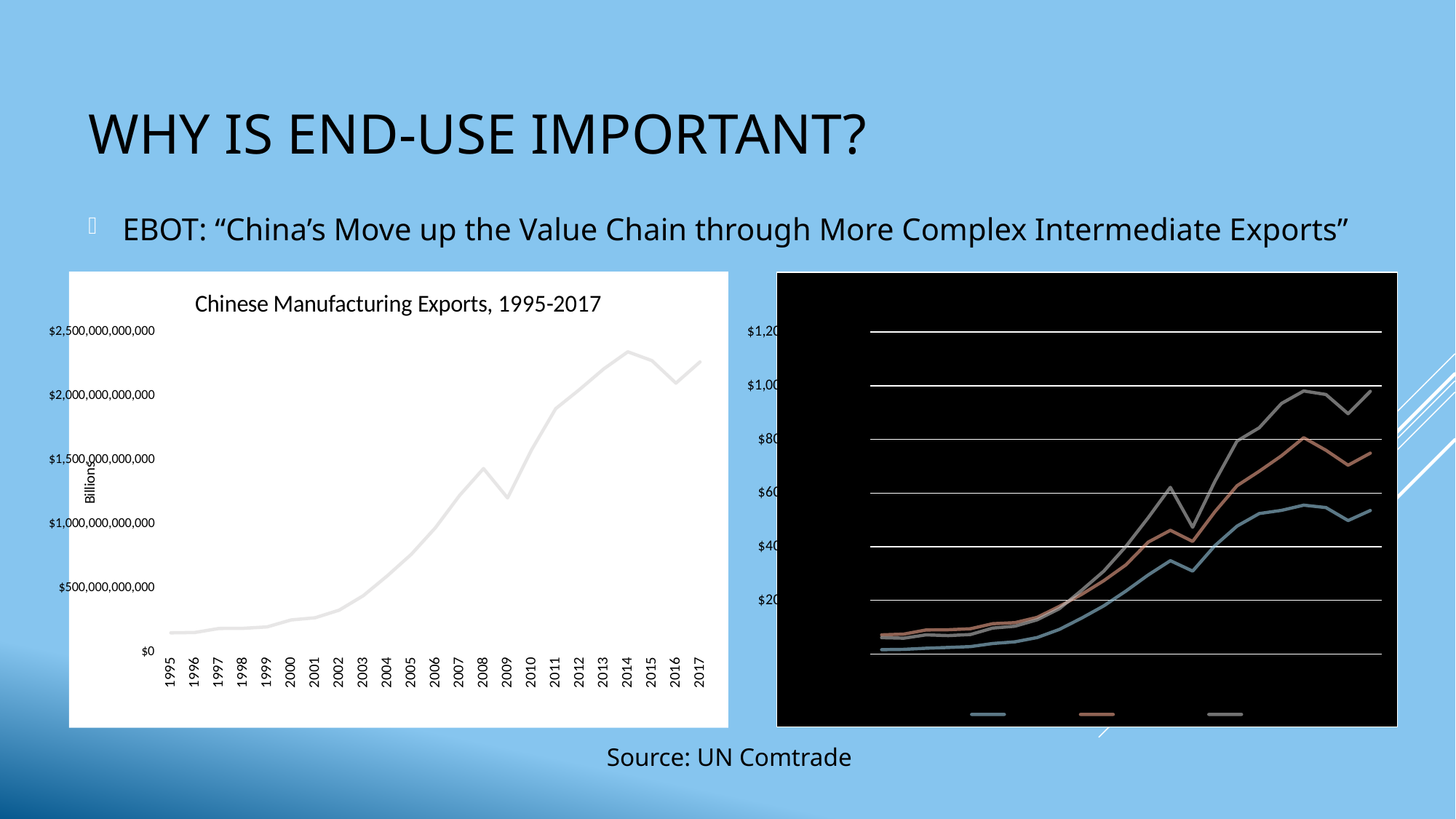
In the 'Chinese Manufacturing Exports, 1995-2017' chart, which year has the larger value, 2008 or 2009? 2008 In the 'Chinese Manufacturing Exports, 1995-2017' chart, is the value for 2009 greater or less than $1,500,000,000,000? less In the 'Chinese Manufacturing Exports, 1995-2017' chart, which year has the larger value, 2014 or 2016? 2014 How many years are plotted on the x axis of the 'Chinese Manufacturing Exports, 1995-2017' chart? 23 How many series does the legend of the chart with the black background on the right list? 3 In the 'Chinese Manufacturing Exports, 1995-2017' chart, which year has the lowest value? 1995 In the 'Chinese Manufacturing Exports, 1995-2017' chart, do the values generally rise or fall from 1995 to 2017? Rise In the 'Chinese Manufacturing Exports, 1995-2017' chart, is the value for 2003 greater or less than $500,000,000,000? less In the 'Chinese Manufacturing Exports, 1995-2017' chart, is the value for 2017 greater or less than $2,000,000,000,000? greater What kind of chart is the chart with the black background on the right of the slide? Line chart What kind of chart is the 'Chinese Manufacturing Exports, 1995-2017' chart on the left? Line chart In the 'Chinese Manufacturing Exports, 1995-2017' chart, which year has the highest value? 2014